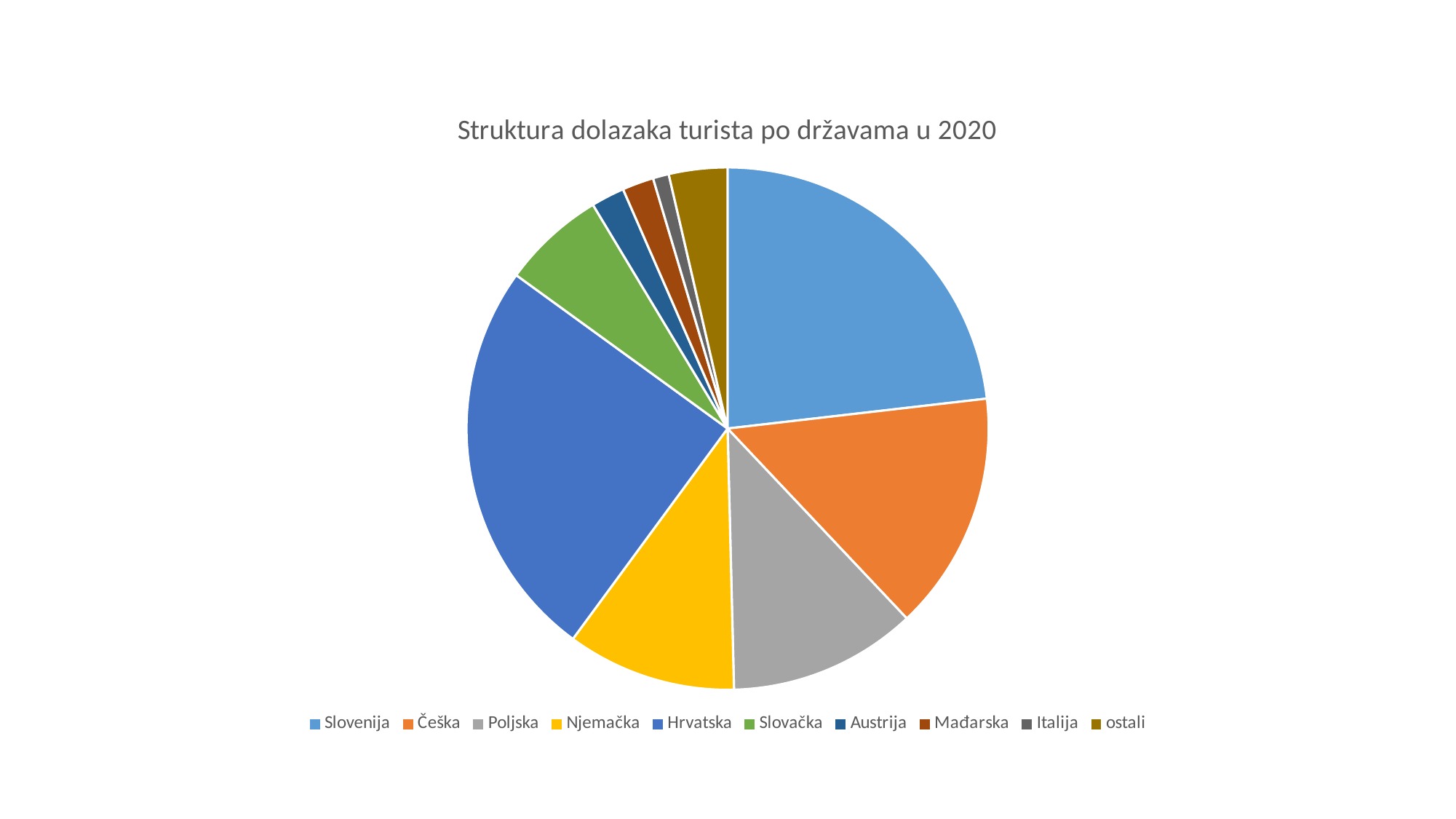
Which country has the largest slice of the pie? Hrvatska What colour is the Njemačka slice? yellow Which category has the smallest slice of the pie? Italija How many categories (slices) does the pie chart have? 10 Which slice is larger, Slovenija or Češka? Slovenija Which slice is larger, Češka or Poljska? Češka What kind of chart is shown on the slide? pie chart Which slice is larger, Slovačka or Austrija? Slovačka How many entries does the legend list? 10 What is the title of the chart? Struktura dolazaka turista po državama u 2020